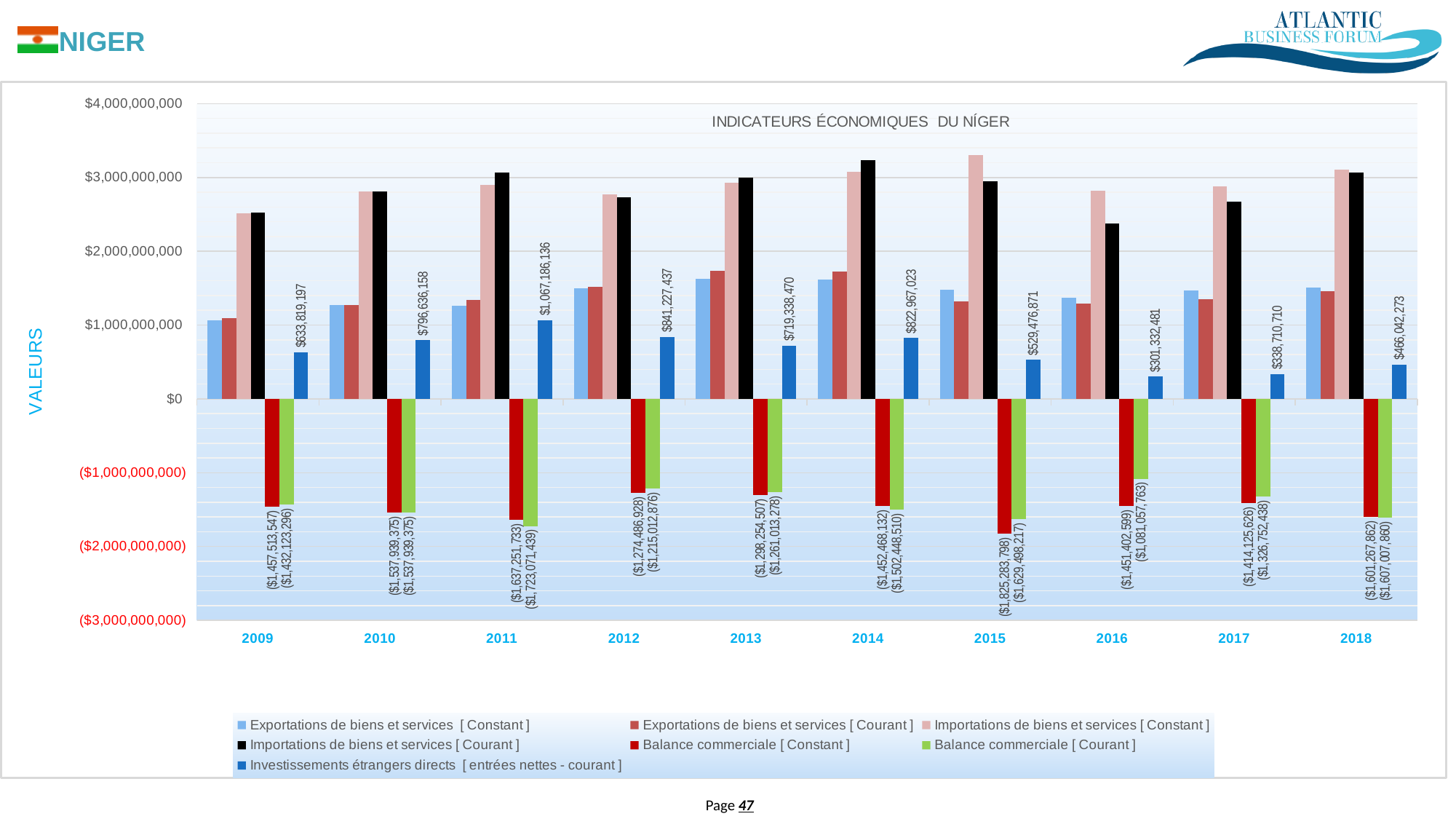
How many series does the legend list? 7 Which year has the larger Investissements étrangers directs value, 2012 or 2013? 2012 In which year is Investissements étrangers directs highest? 2011 What is the value of Investissements étrangers directs for 2018? $466,042,273 In which year is Investissements étrangers directs lowest? 2016 What kind of chart is shown on the slide? bar chart What is the title of the chart? INDICATEURS ÉCONOMIQUES DU NÍGER What is the value of Balance commerciale [Constant] for 2015? ($1,825,283,798) Is the value of Importations de biens et services [Constant] for 2015 greater or less than $3,000,000,000? greater What is the difference between Investissements étrangers directs in 2010 and in 2009? $162,816,961 How many years are shown on the x axis? 10 What is the value of Investissements étrangers directs for 2011? $1,067,186,136